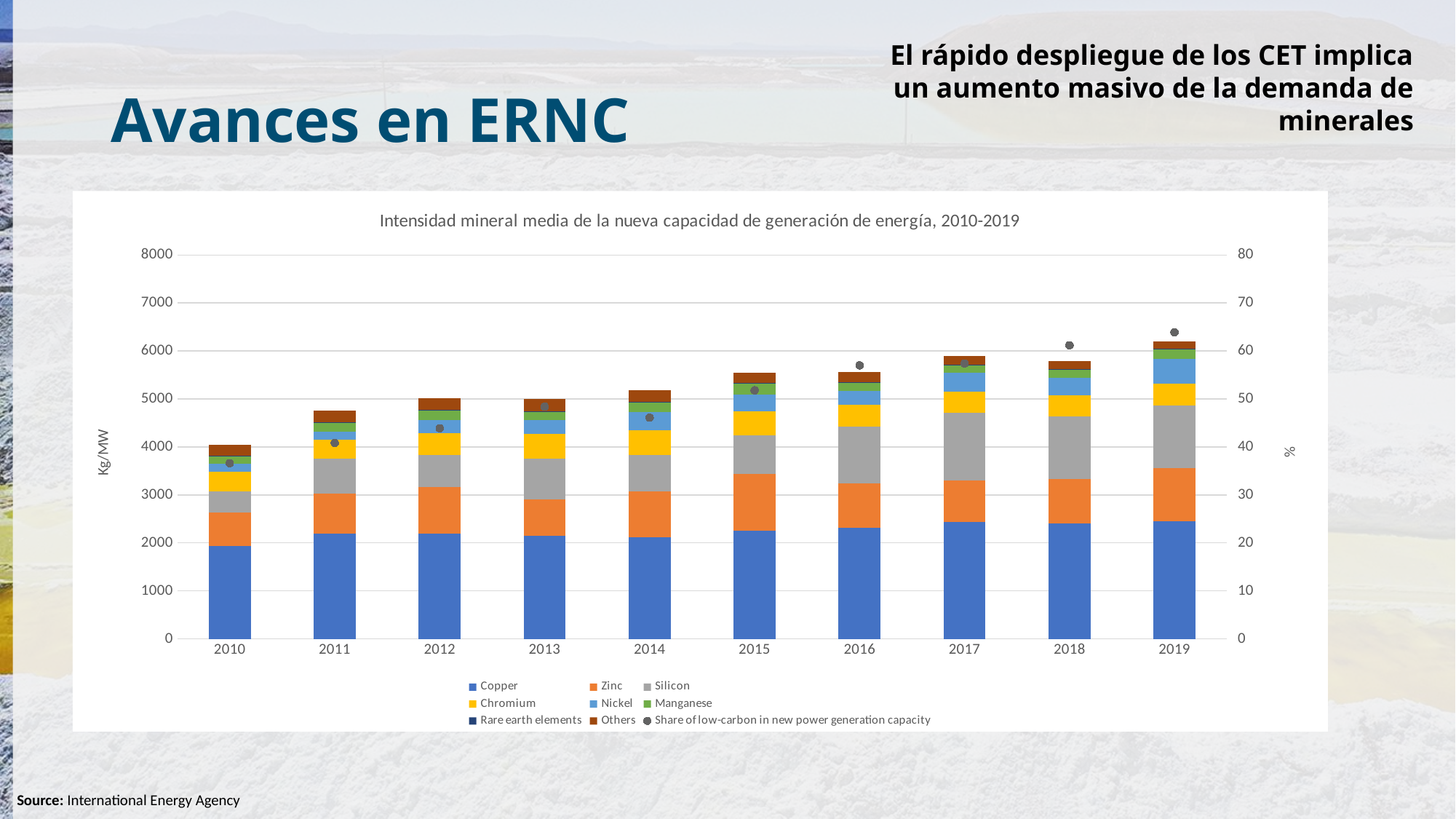
What kind of chart is shown on the slide? Stacked bar chart with a dot series Is the total stacked bar for 2010 greater or less than 5000 Kg/MW? less What is the label of the left vertical axis? Kg/MW Is the total stacked bar for 2019 greater or less than 6000 Kg/MW? greater How many series does the chart legend list? 9 Which year has the tallest stacked bar? 2019 How many years are shown on the x axis of the chart? 10 Is the share of low-carbon in new power generation capacity for 2010 greater or less than 40%? less What is the title of the chart? Intensidad mineral media de la nueva capacidad de generación de energía, 2010-2019 Does the share of low-carbon in new power generation capacity generally rise or fall from 2010 to 2019? rise Which year has the shortest stacked bar? 2010